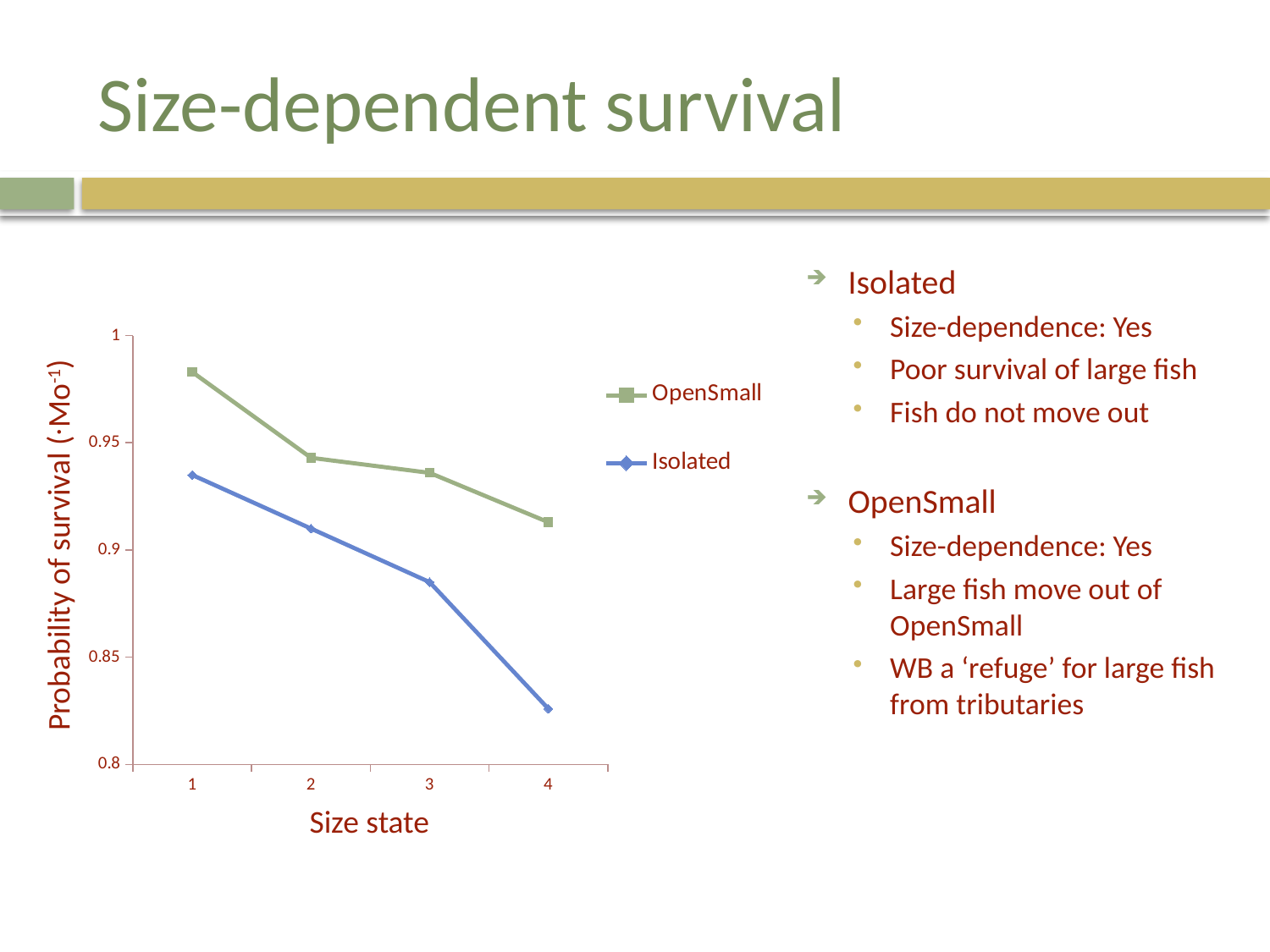
How many size states are plotted along the x axis? 4 Is the value for OpenSmall at size state 4 greater or less than 0.9? greater At size state 4, which series has the higher probability of survival, OpenSmall or Isolated? OpenSmall Is the value for Isolated at size state 4 greater or less than 0.85? less What is the label of the y axis? Probability of survival (·Mo-1) What kind of chart is shown on the slide? line chart Do the values for the OpenSmall series rise or fall as size state increases? fall How many series does the chart legend list? 2 Is the value for OpenSmall at size state 1 greater or less than 0.95? greater Do the values for the Isolated series rise or fall as size state increases? fall